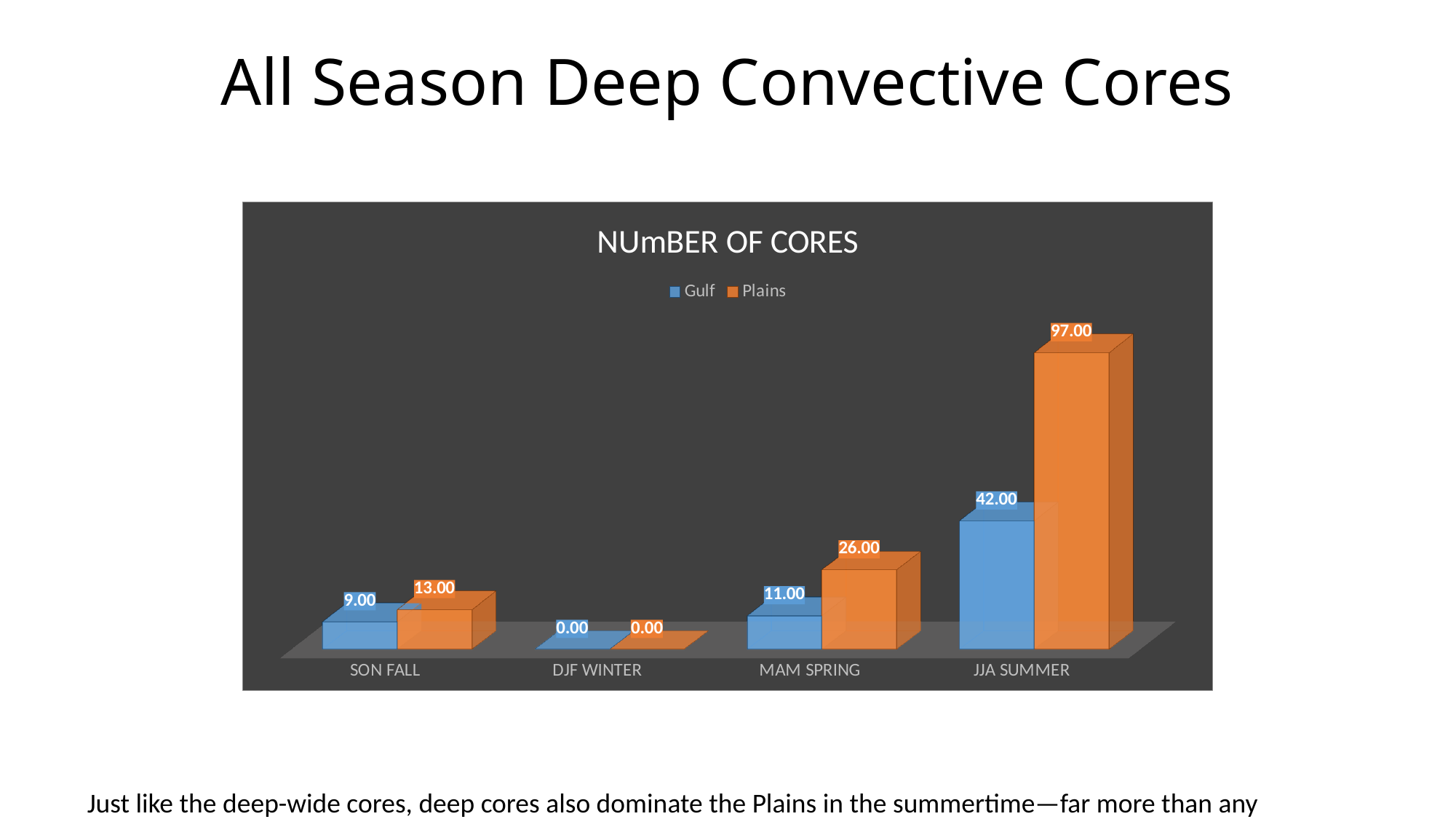
Which is larger for MAM SPRING, the Gulf value or the Plains value? Plains What kind of chart is shown? Bar chart Which season has the highest Gulf value? JJA SUMMER What is the Gulf value for MAM SPRING? 11.00 Which season has the lowest Plains value? DJF WINTER What is the Plains value for JJA SUMMER? 97.00 What is the title of the chart? NUmBER OF CORES What is the Gulf value for SON FALL? 9.00 What is the Plains value for DJF WINTER? 0.00 How many seasons are shown on the x axis? 4 What is the difference between the Plains and Gulf values for JJA SUMMER? 55.00 How many series does the legend list? 2